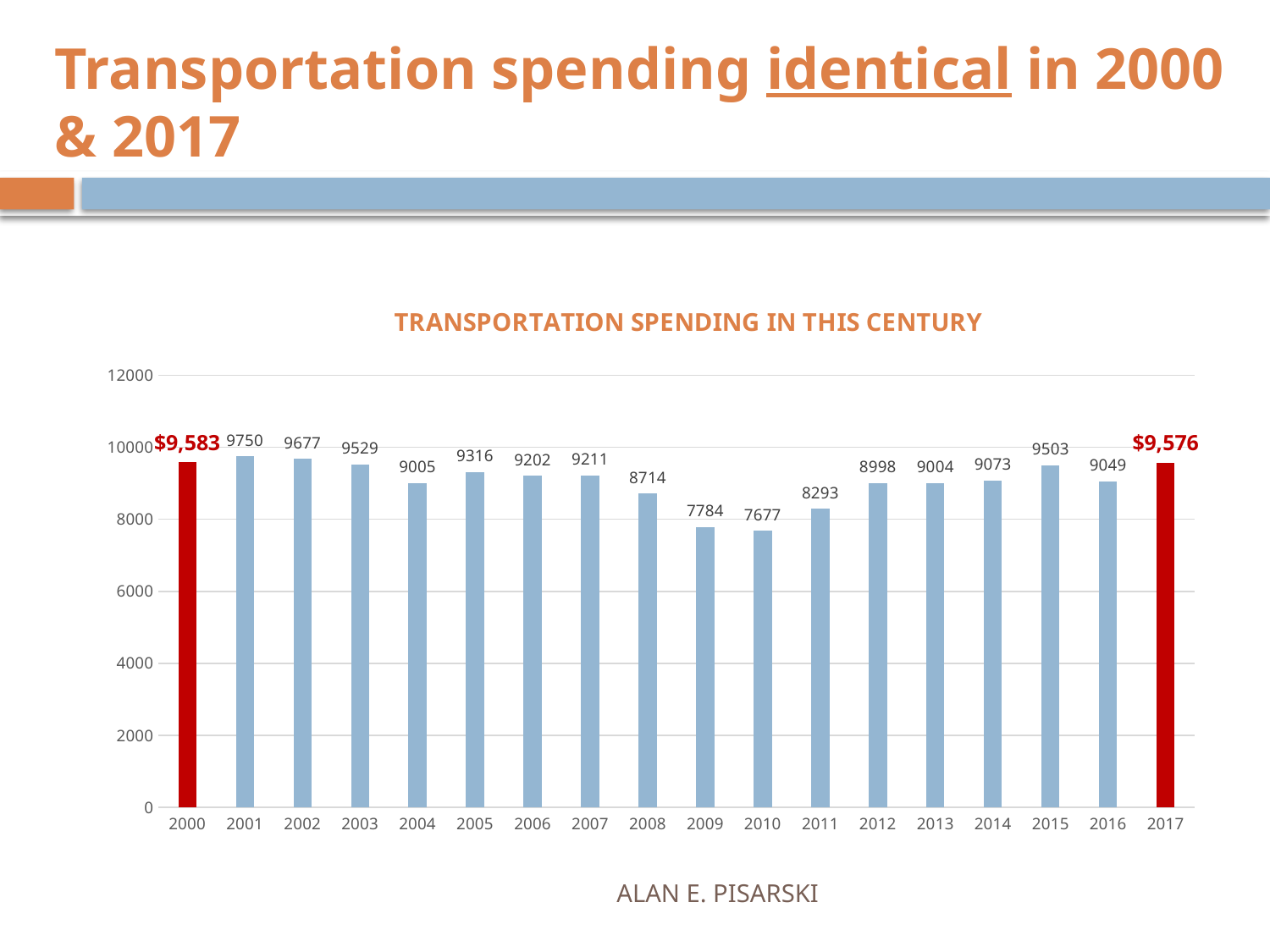
What is the value labelled on the bar for 2017? $9,576 Which year has the lowest transportation spending? 2010 How many years are shown on the x axis? 18 Is the value for 2009 greater or less than 8000? less Which year has the larger value, 2004 or 2005? 2005 What is the value labelled on the bar for 2000? $9,583 What is the transportation spending value shown for 2010? 7677 What is the difference between the 2001 value and the 2010 value? 2073 What is the title of the chart? TRANSPORTATION SPENDING IN THIS CENTURY What kind of chart is shown on the slide? Bar chart Which year has the highest transportation spending? 2001 Do the values rise or fall from 2010 to 2015? Rise